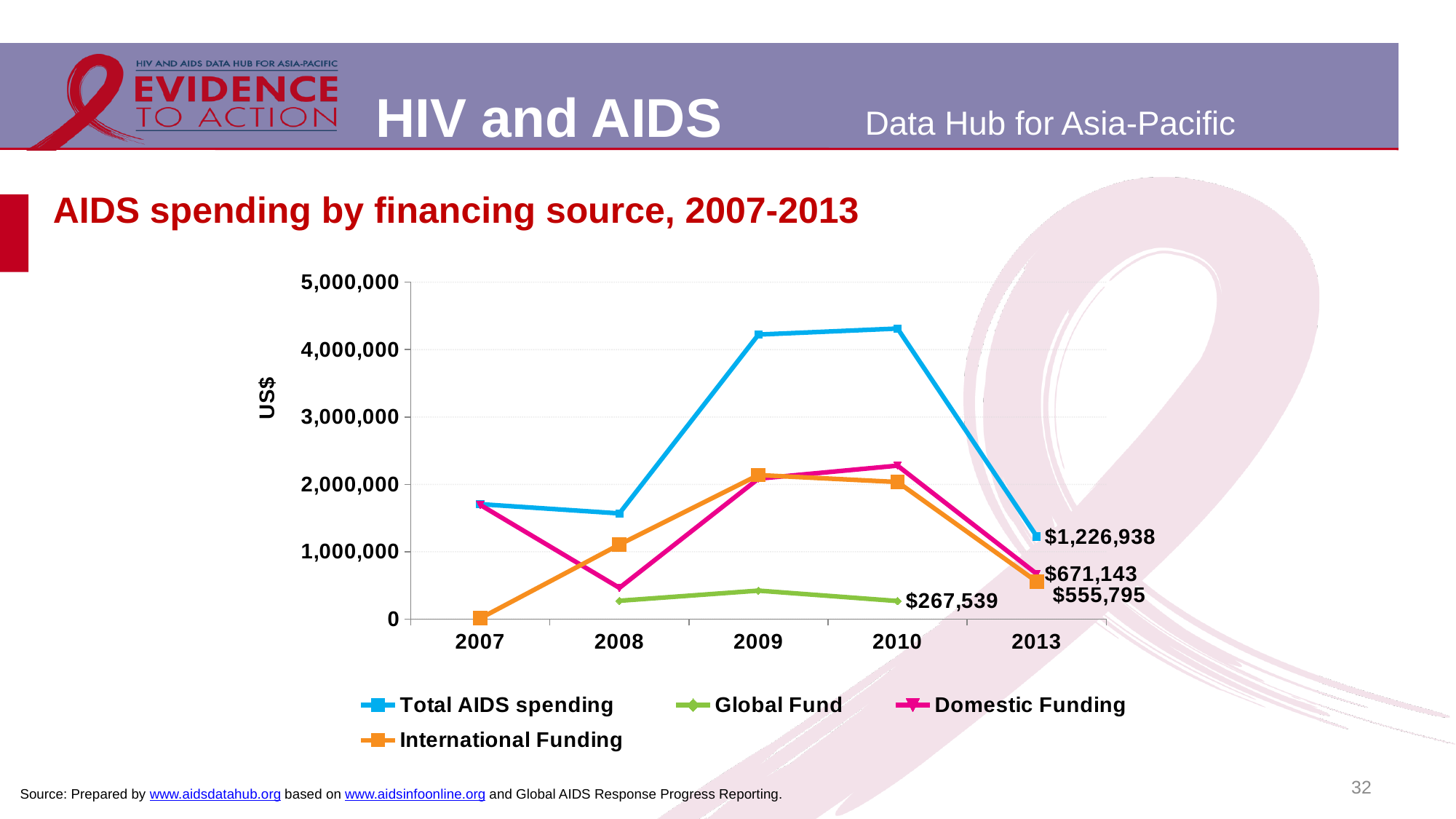
What is the difference between Domestic Funding and International Funding in 2013? $115,348 In 2013, which is larger: Domestic Funding or International Funding? Domestic Funding How many series does the legend list? 4 What type of chart is shown on the slide? Line chart Does Total AIDS spending rise or fall from 2010 to 2013? Fall What is the value of Total AIDS spending in 2013? $1,226,938 What is the value of International Funding in 2013? $555,795 Is the value for Total AIDS spending in 2010 greater or less than 4,000,000? greater How many years are shown on the x axis? 5 Which series has the lowest value in 2013? International Funding What is the value of Domestic Funding in 2013? $671,143